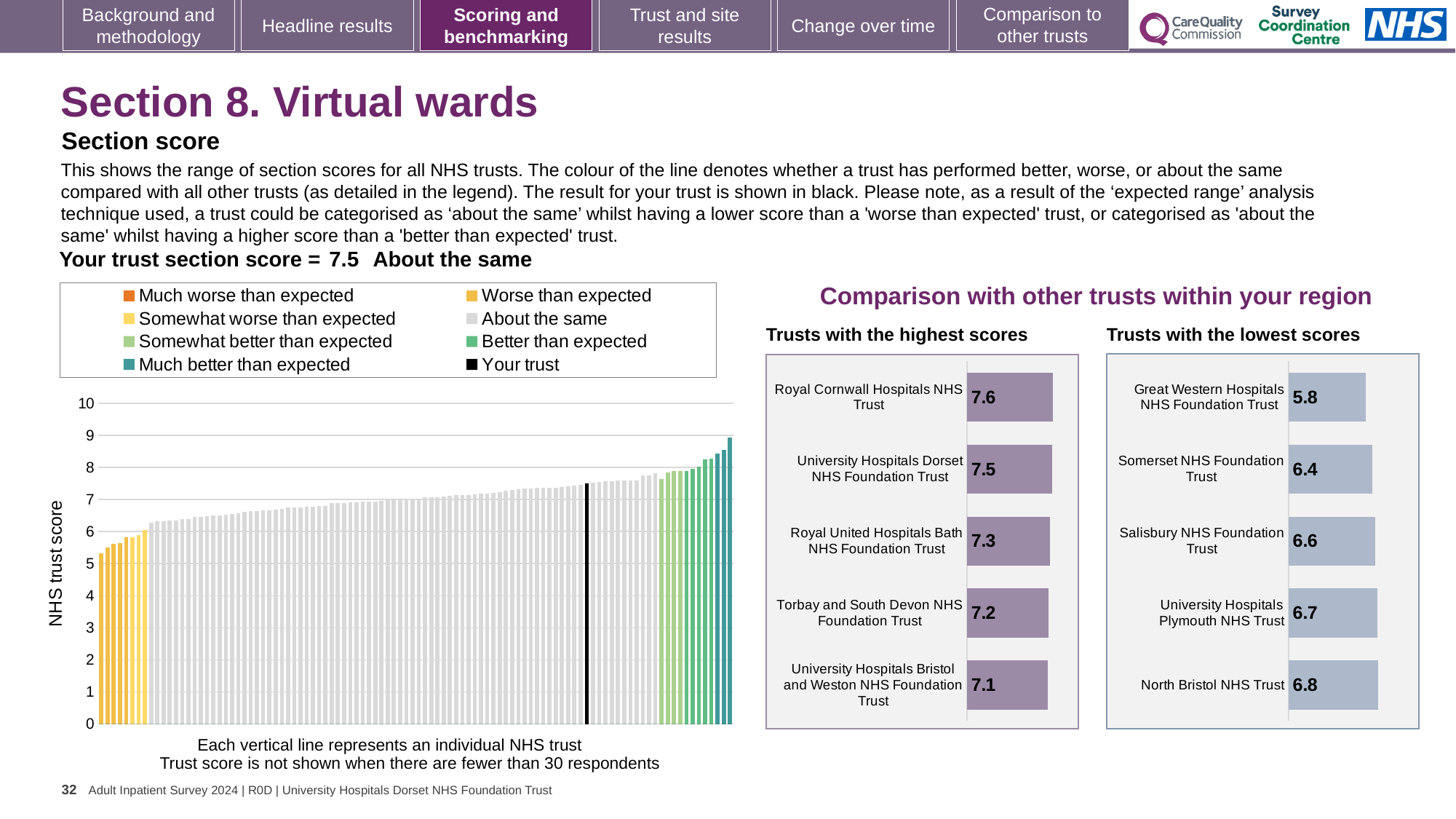
In the 'Trusts with the lowest scores' chart, which has the larger score: Salisbury NHS Foundation Trust or North Bristol NHS Trust? North Bristol NHS Trust In the NHS trust score chart on the left, is the value of the tallest bar greater or less than 8? greater In the 'Trusts with the lowest scores' chart, which trust has the lowest score? Great Western Hospitals NHS Foundation Trust In the NHS trust score chart on the left, what colour is used to show 'Your trust'? Black In the 'Trusts with the lowest scores' chart, what is the score for Somerset NHS Foundation Trust? 6.4 In the 'Trusts with the highest scores' chart, which trust has the highest score? Royal Cornwall Hospitals NHS Trust What type of chart is the 'Trusts with the highest scores' chart? Bar chart In the NHS trust score chart on the left, do the bar values rise or fall from left to right? Rise In the 'Trusts with the highest scores' chart, what is the difference between the scores of Royal Cornwall Hospitals NHS Trust and University Hospitals Bristol and Weston NHS Foundation Trust? 0.5 In the 'Trusts with the highest scores' chart, what is the score for Royal Cornwall Hospitals NHS Trust? 7.6 How many trusts are shown in the 'Trusts with the lowest scores' chart? 5 How many entries does the legend of the NHS trust score chart on the left list? 8